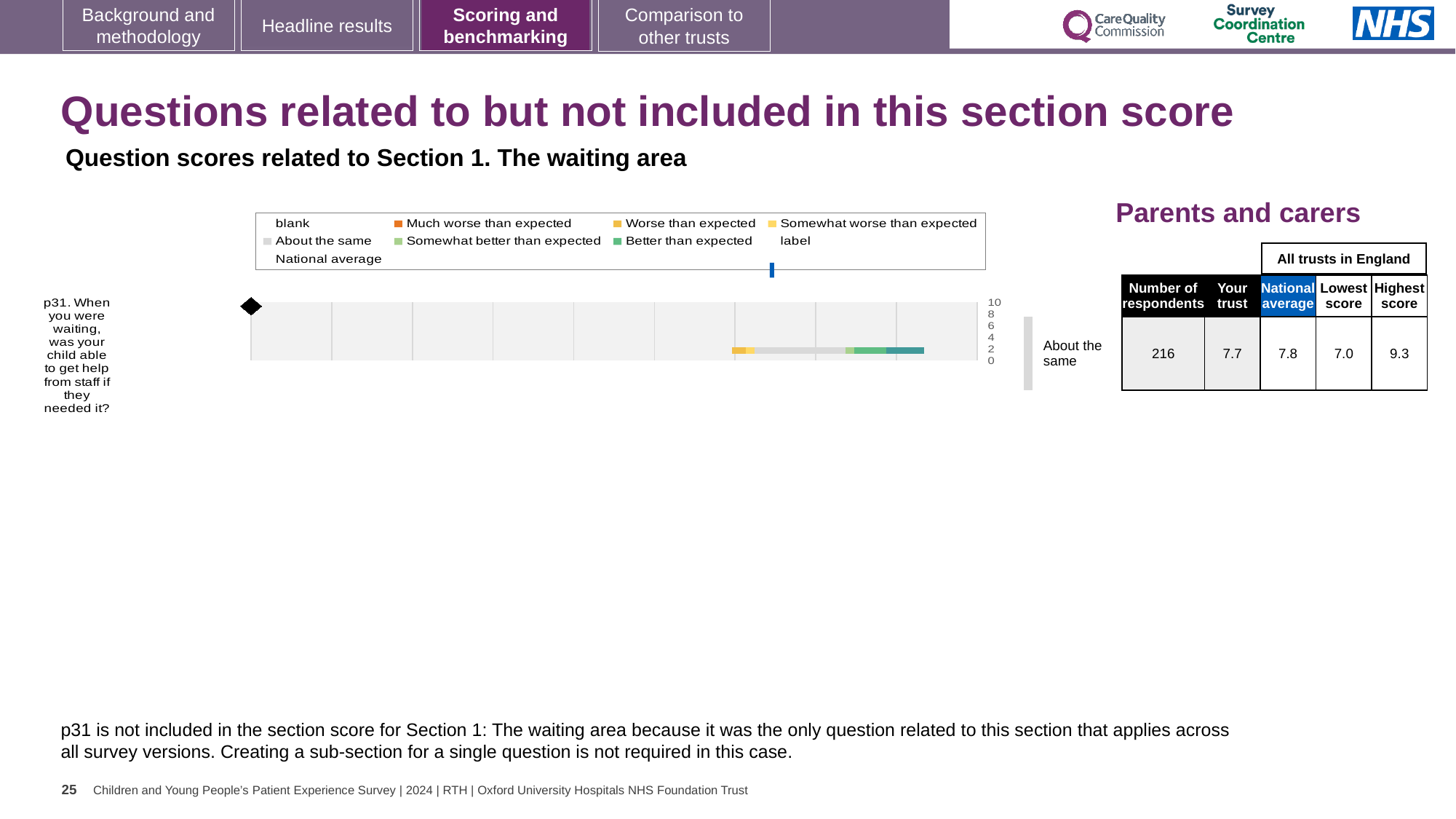
How many questions are plotted in the chart? 1 What is the national average score for p31? 7.8 What is the highest score among all trusts in England for p31? 9.3 What kind of chart is shown on the slide? bar chart How many respondents answered p31? 216 Which is larger for p31, the 'Your trust' score or the national average? National average What is the difference between the highest score and the lowest score for p31? 2.3 What benchmark category is shown next to the bar for p31? About the same What is the lowest score among all trusts in England for p31? 7.0 Which question is plotted in the chart? p31. When you were waiting, was your child able to get help from staff if they needed it? What is the 'Your trust' score for p31? 7.7 What is the difference between the national average and the 'Your trust' score for p31? 0.1